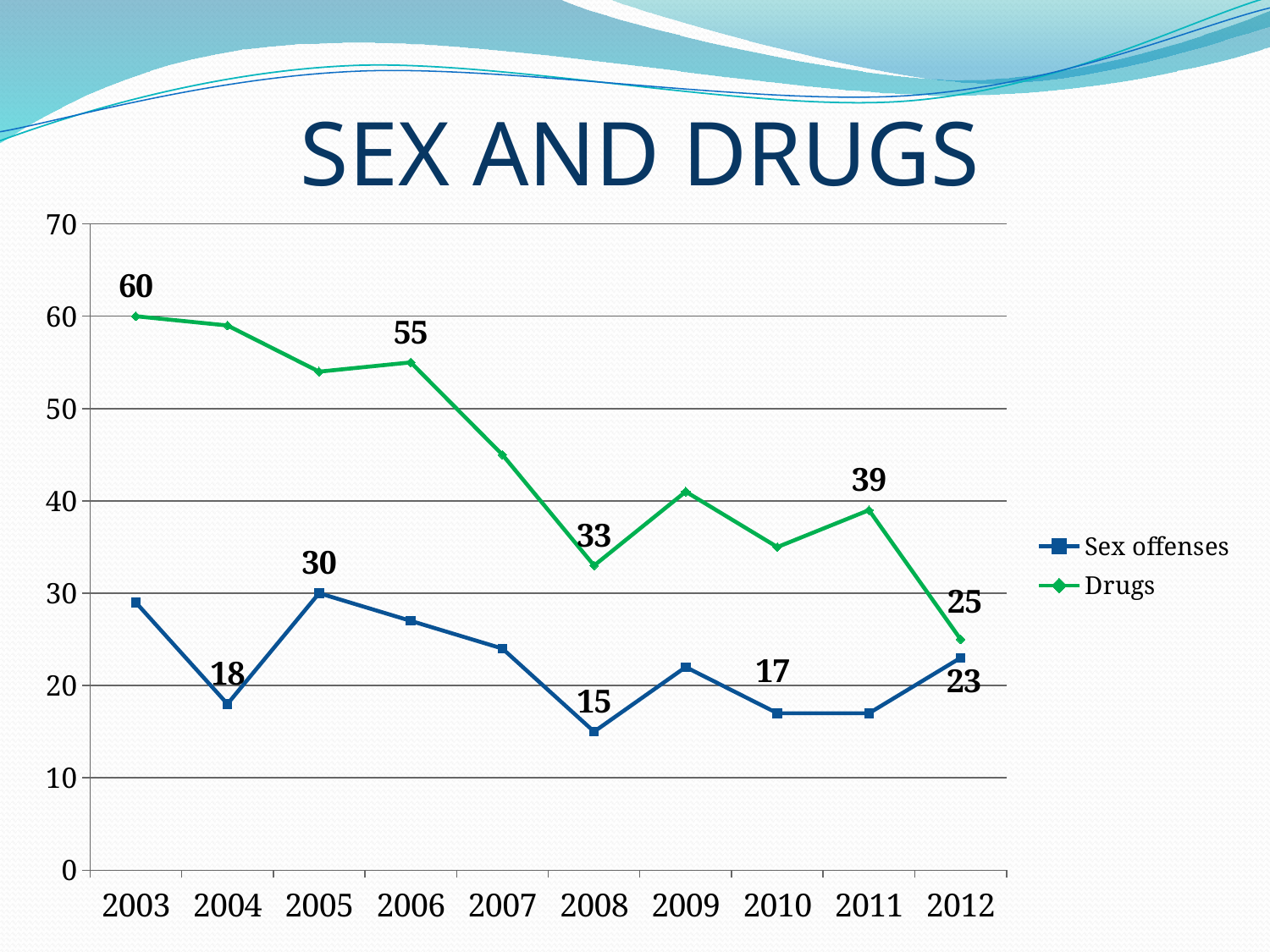
In 2008, which series has the larger value, Drugs or Sex offenses? Drugs How many years are shown on the x axis? 10 What is the value for Drugs in 2012? 25 In which year is the Sex offenses series at its lowest? 2008 What is the value for Sex offenses in 2005? 30 What is the value for Drugs in 2003? 60 Is the value for Drugs in 2007 greater or less than 50? less What is the value for Sex offenses in 2008? 15 By how much did the Drugs value fall from 2003 to 2012? 35 In which year is the Drugs series at its lowest? 2012 What is the difference between the Sex offenses values in 2005 and 2004? 12 What kind of chart is shown on the slide? line chart